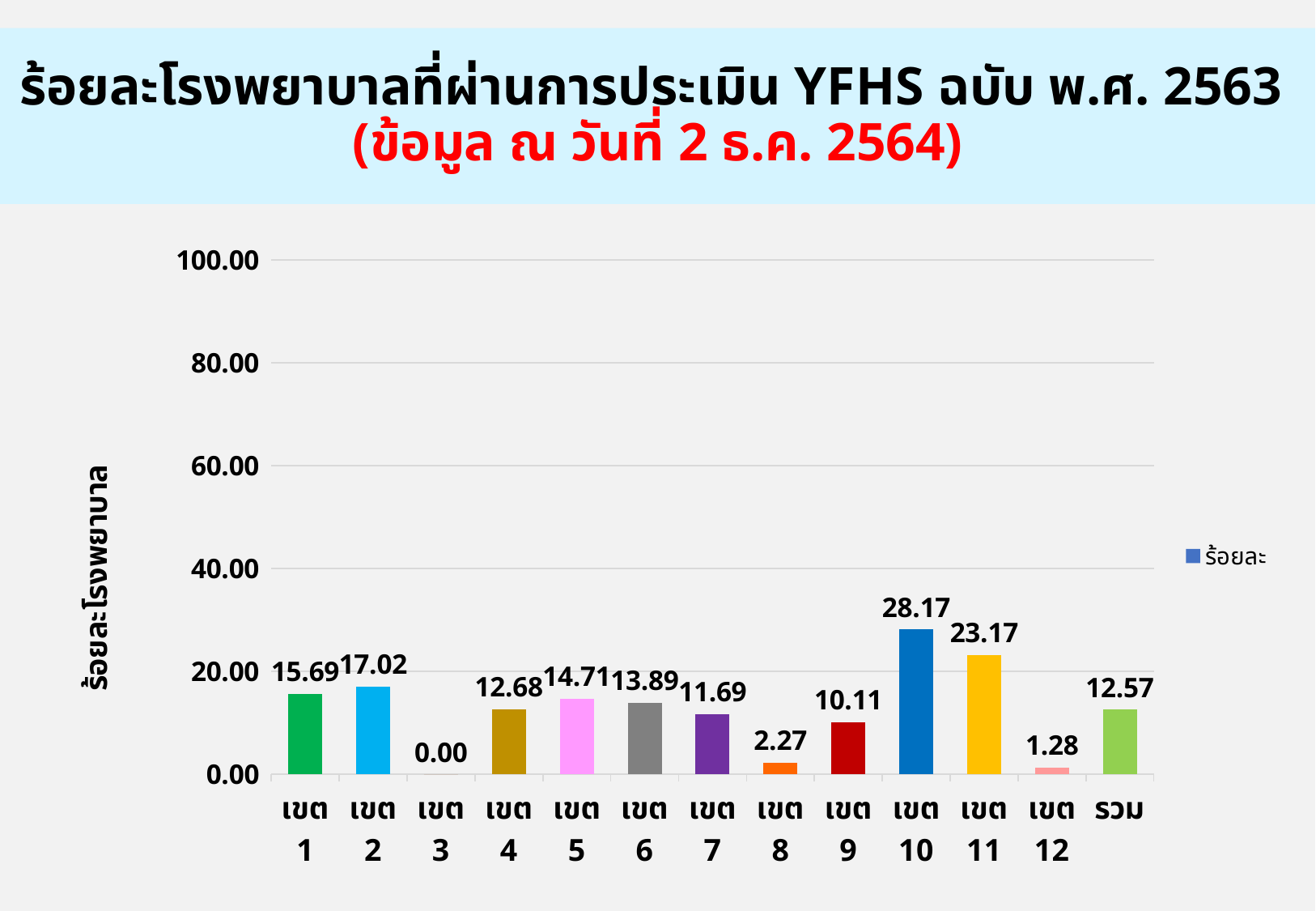
What is the value for รวม? 12.57 How many series does the legend list? 1 What is the value for เขต 3? 0.00 Which is larger, the value for เขต 2 or the value for เขต 1? เขต 2 Which category has the lowest value? เขต 3 How many categories are shown on the x axis? 13 What is the value for เขต 10? 28.17 What kind of chart is shown on the slide? bar chart Which category has the highest value? เขต 10 What is the difference between the values for เขต 10 and เขต 11? 5.00 What is the legend entry for the series? ร้อยละ Is the value for เขต 11 greater or less than 20.00? greater